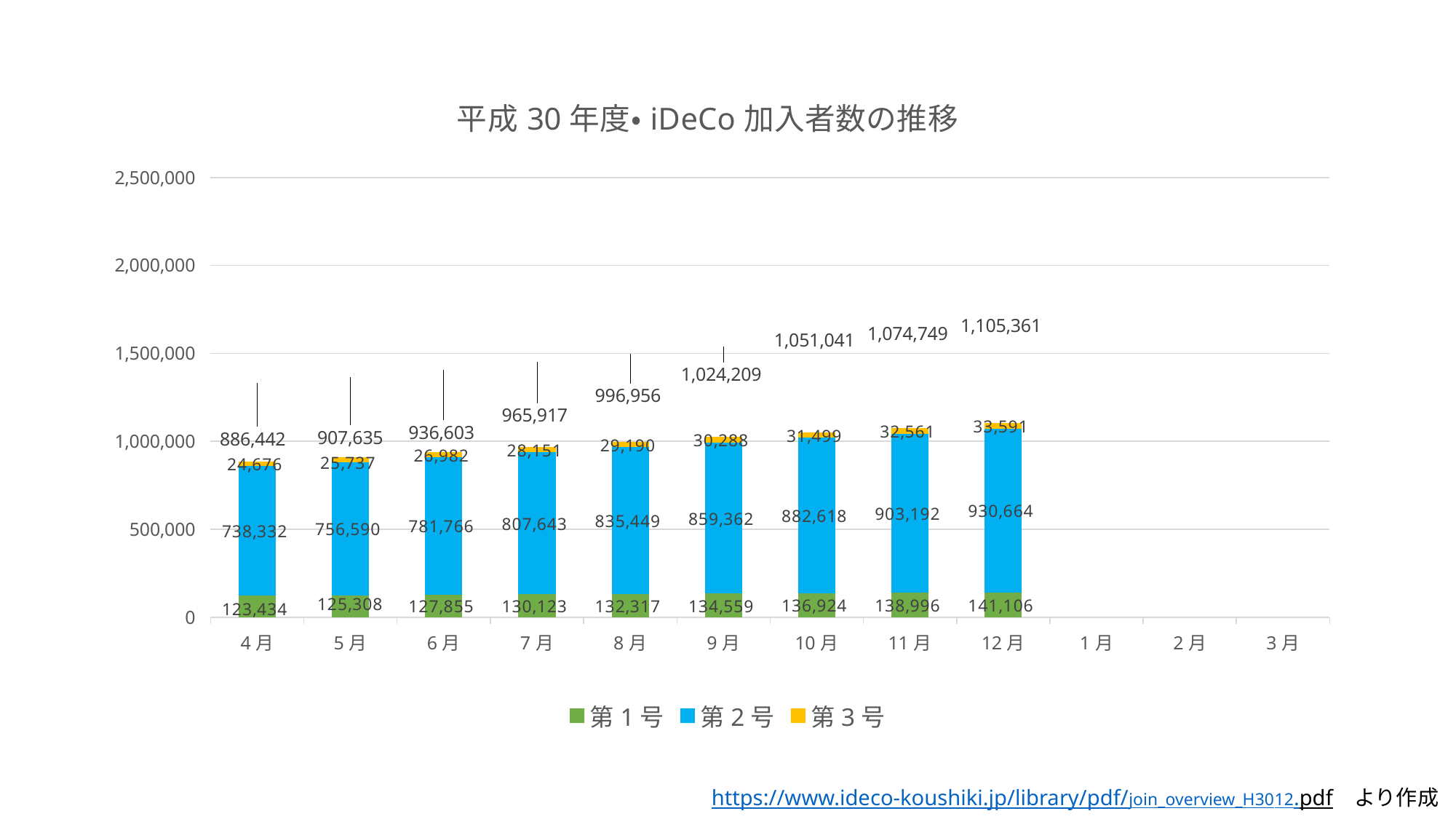
How many months on the x axis have bars plotted? 9 What type of chart is shown on the slide? stacked bar chart Which month has the highest total number of iDeCo subscribers? 12月 How many series does the legend list? 3 What is the value for 第2号 in 7月? 807,643 What is the total of the stacked bar for 12月? 1,105,361 Which month with data has the lowest value for 第2号? 4月 Which is larger, the 第1号 value in 9月 or the 第1号 value in 6月? 9月 What is the value for 第1号 in 10月? 136,924 What is the value for 第3号 in 5月? 25,737 Do the total values rise or fall from 4月 to 12月? rise What is the difference between the 第2号 values for 12月 and 4月? 192,332